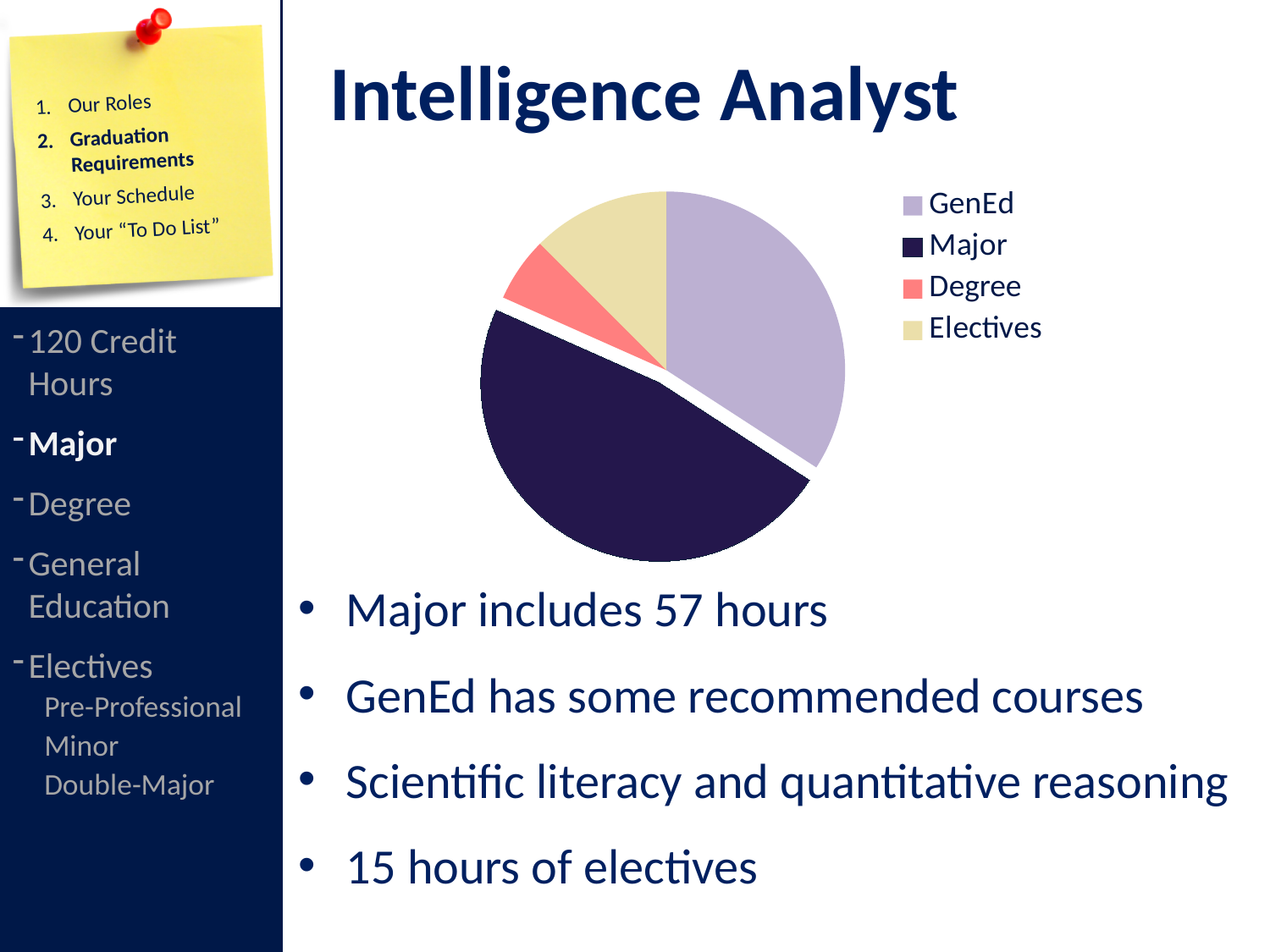
Which category has the largest slice in the pie chart? Major Which category has the smallest slice in the pie chart? Degree Which slice is larger in the pie chart, GenEd or Electives? GenEd How many entries does the legend of the pie chart list? 4 Which slice is larger in the pie chart, Major or GenEd? Major Which category is shown in the light purple colour in the pie chart? GenEd Which slice is larger in the pie chart, Degree or Electives? Electives How many slices does the pie chart have? 4 Which slice of the pie chart is pulled out (exploded) from the rest? Major What kind of chart is shown on the slide? pie chart